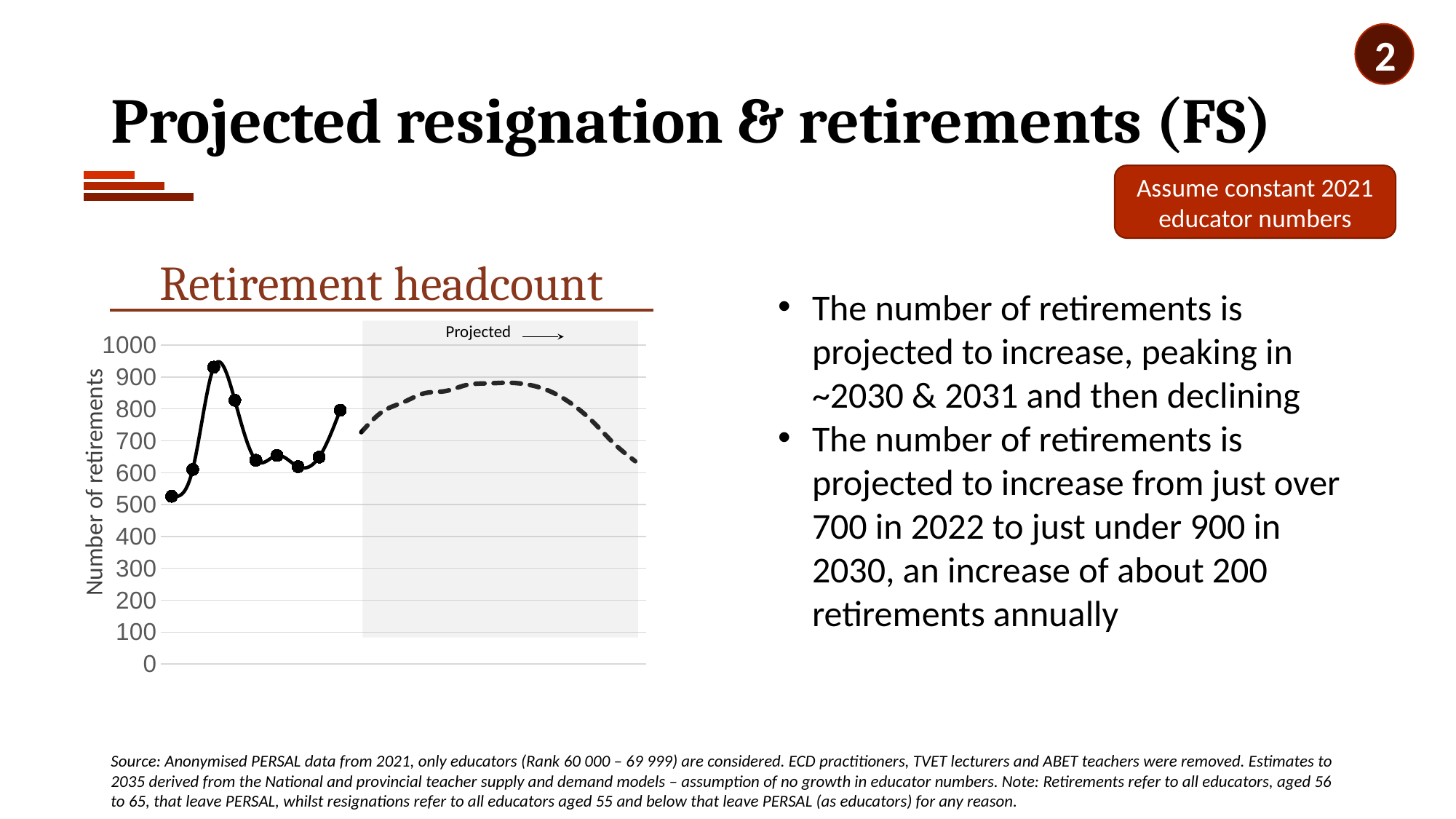
What kind of chart is the Retirement headcount chart? line chart What is the title of the chart on the slide? Retirement headcount How many data point markers are shown on the solid (actual) line of the Retirement headcount chart? 9 Does the dashed projected line on the Retirement headcount chart rise or fall at the start of the shaded projected region? rise Is the highest point on the solid line of the Retirement headcount chart greater or less than 900? greater Does the dashed projected line on the Retirement headcount chart rise or fall towards the right end of the chart? fall Is the peak of the dashed projected line on the Retirement headcount chart greater or less than 900? less Is the final point of the dashed projected line on the Retirement headcount chart greater or less than 700? less What is the highest value shown on the vertical axis of the Retirement headcount chart? 1000 What is the interval between consecutive tick labels on the vertical axis of the Retirement headcount chart? 100 What is the label on the vertical axis of the Retirement headcount chart? Number of retirements